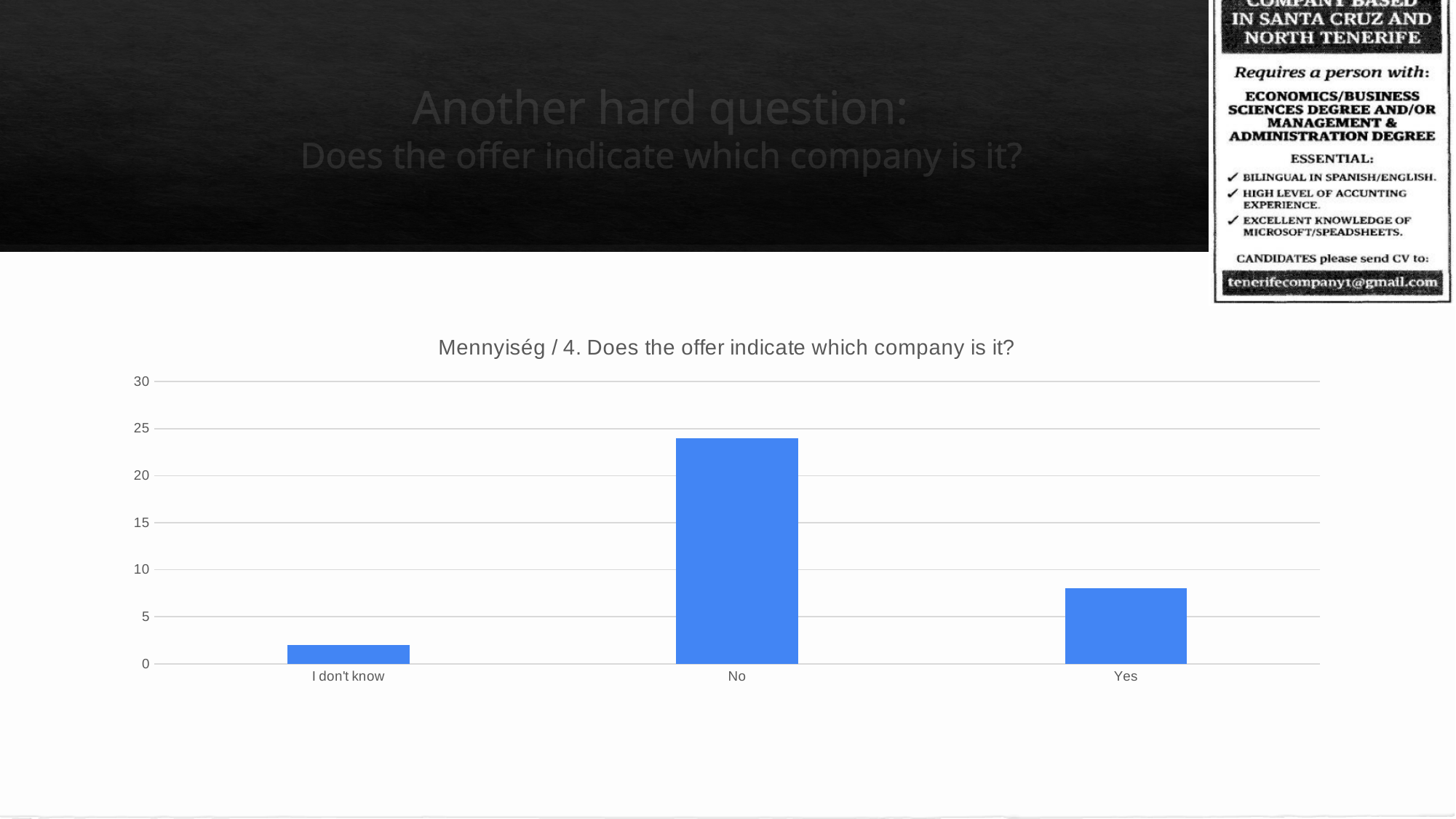
How many categories are shown on the x axis of the chart? 3 Which is larger, the value for No or the value for Yes? No What is the title of the chart? Mennyiség / 4. Does the offer indicate which company is it? Which category has the highest bar in the chart? No Is the value for Yes greater or less than 10? less Is the value for Yes greater or less than 5? greater What kind of chart is shown on the slide? bar chart Is the value for I don't know greater or less than 5? less Which category has the lowest bar in the chart? I don't know Which is larger, the value for Yes or the value for I don't know? Yes